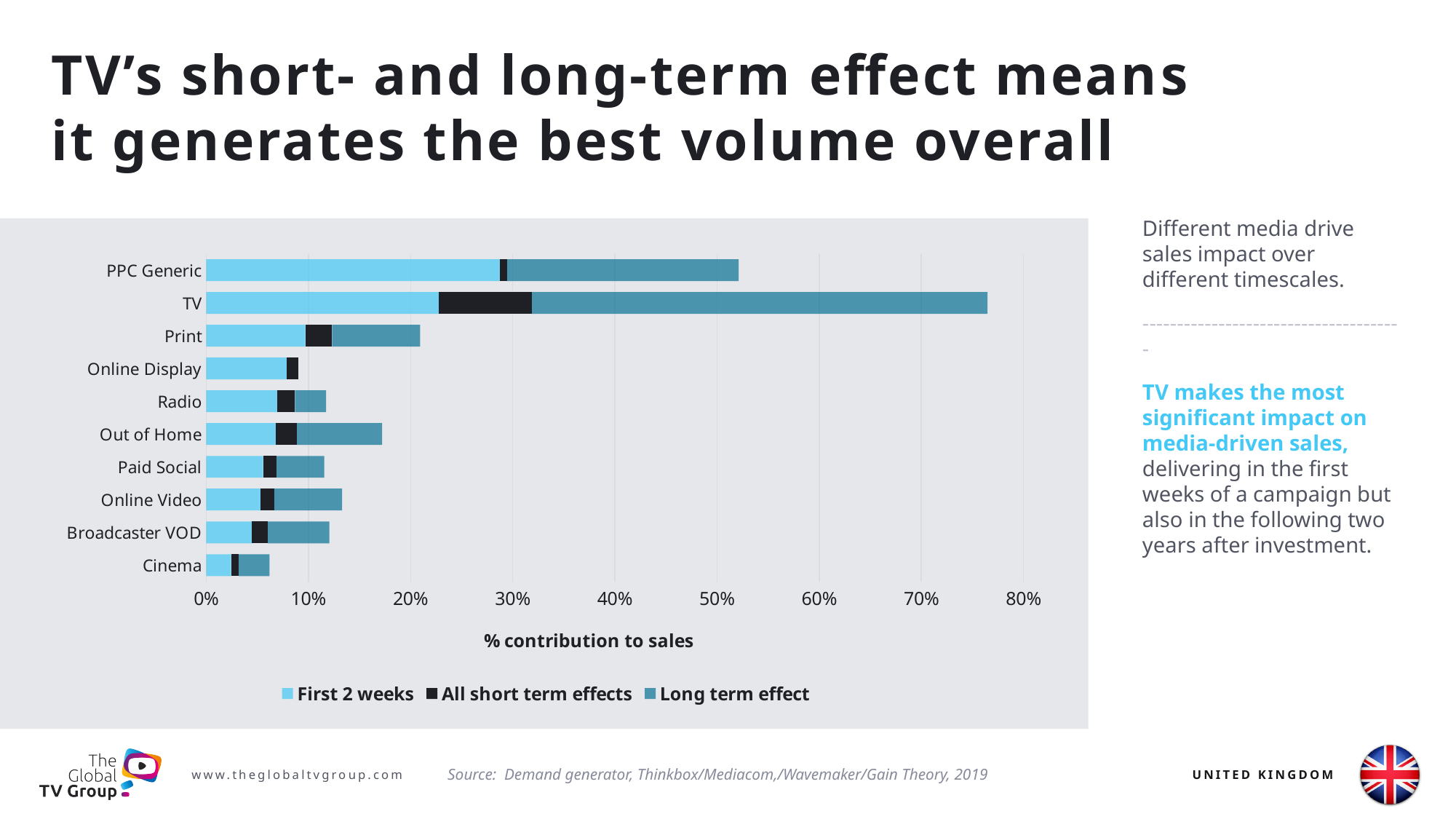
What is the title of the x axis? % contribution to sales Is the total value for Print greater or less than 30%? less Which media category has the lowest total % contribution to sales? Cinema Is the total value for Out of Home greater or less than 10%? greater Is the total value for TV greater or less than 70%? greater How many media categories are plotted on the chart? 10 How many series does the legend list? 3 What kind of chart is shown on the slide? Stacked bar chart Which has a larger total % contribution to sales, TV or PPC Generic? TV Which has a larger total % contribution to sales, Out of Home or Radio? Out of Home Which media category has the highest total % contribution to sales? TV